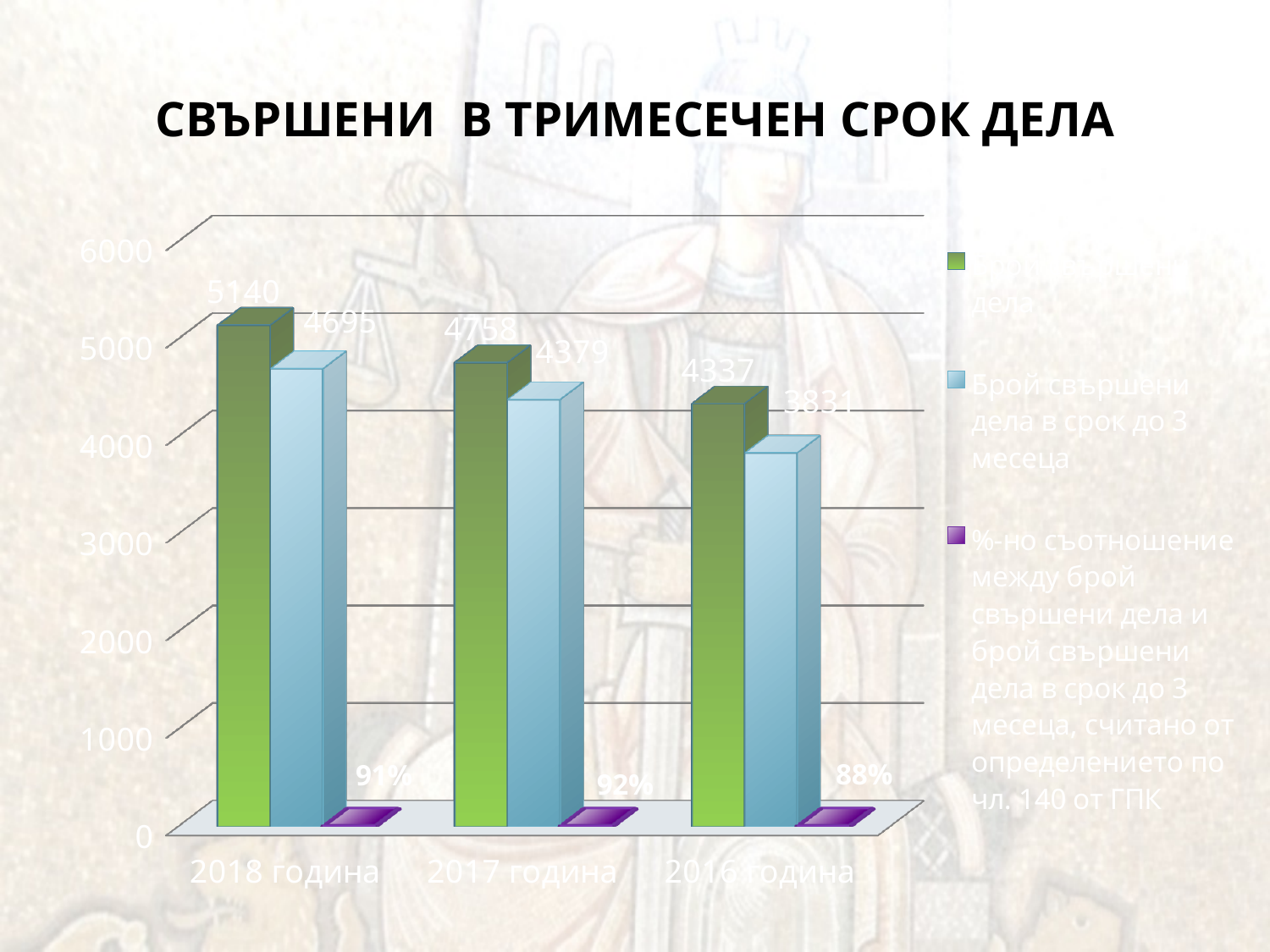
Which year has the highest value of "Брой свършени дела"? 2018 година What is the title of the chart? СВЪРШЕНИ В ТРИМЕСЕЧЕН СРОК ДЕЛА What kind of chart is shown on the slide? Bar chart What percentage is shown for 2017 година? 92% Which is larger: "Брой свършени дела" for 2017 година or for 2016 година? 2017 година What is the value of "Брой свършени дела" for 2018 година? 5140 What is the value of "Брой свършени дела в срок до 3 месеца" for 2017 година? 4379 What is the difference between "Брой свършени дела" and "Брой свършени дела в срок до 3 месеца" for 2018 година? 445 What is the value of "Брой свършени дела в срок до 3 месеца" for 2016 година? 3831 How many year categories are shown on the x axis? 3 How many series does the legend list? 3 Which year has the lowest percentage value? 2016 година